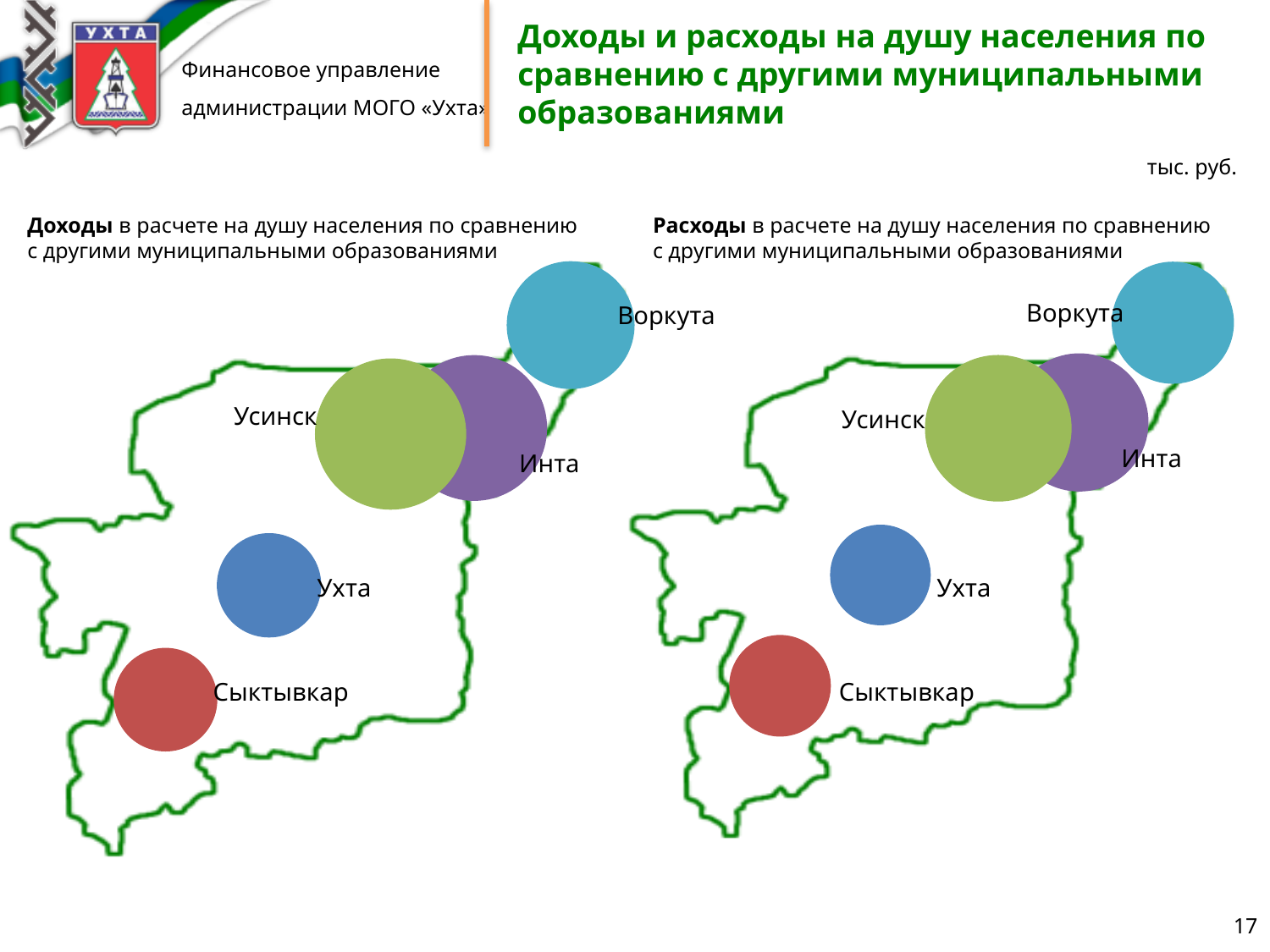
What unit is stated for the values on the slide? тыс. руб. What kind of chart is used on the left (Доходы) chart? bubble chart What colour is the bubble for Ухта on both charts? blue On the left (Доходы) chart, which bubble is larger, Усинск or Ухта? Усинск On the left (Доходы) chart, which municipality has the largest bubble? Усинск How many municipalities are shown on the right (Расходы) chart? 5 On the left (Доходы) chart, which bubble is larger, Инта or Сыктывкар? Инта On the right (Расходы) chart, which municipality has the largest bubble? Усинск On the right (Расходы) chart, which bubble is larger, Воркута or Ухта? Воркута What kind of chart is used on the right (Расходы) chart? bubble chart How many municipalities are shown on the left (Доходы) chart? 5